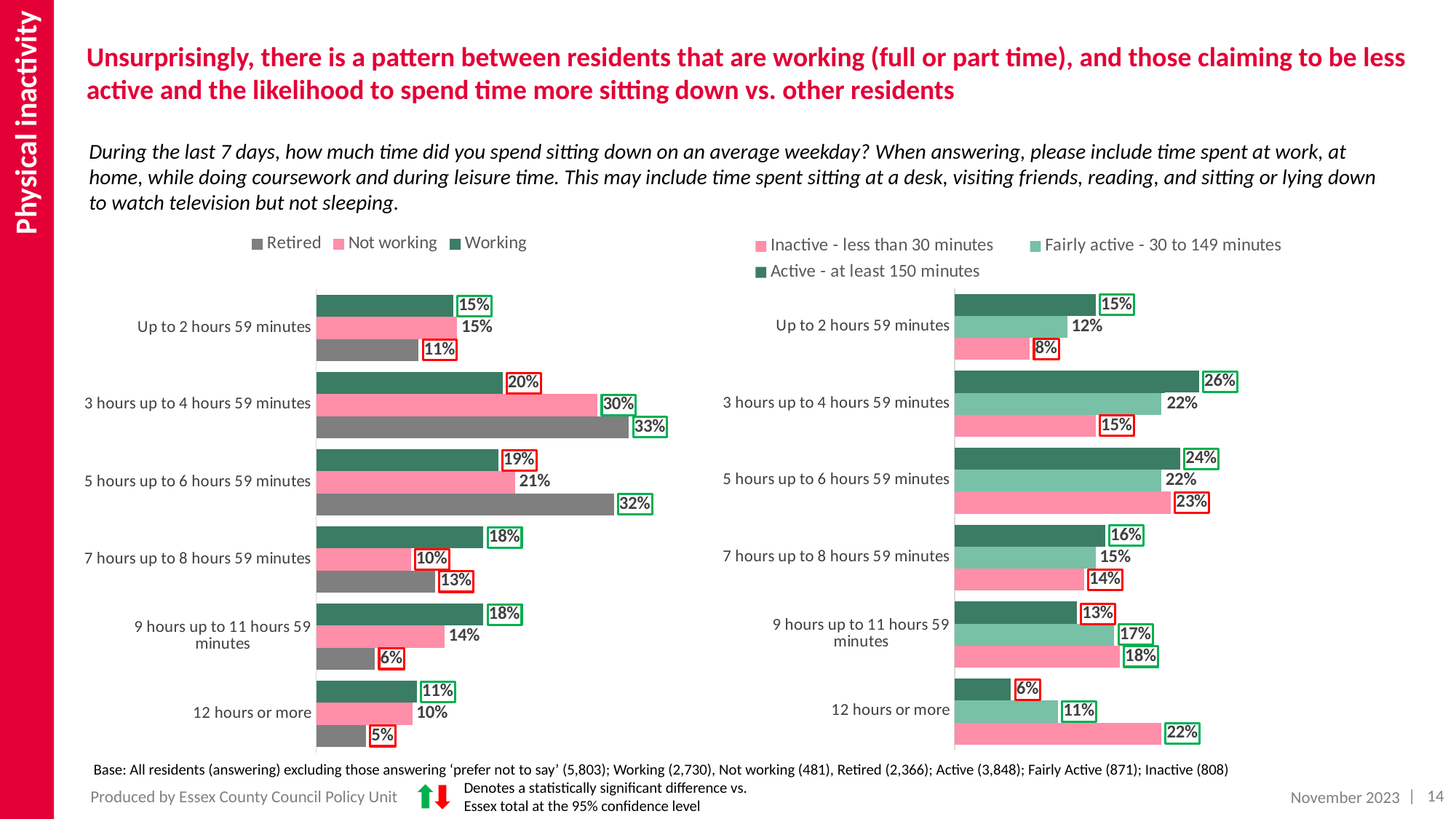
In the left chart, which is larger for 9 hours up to 11 hours 59 minutes: the Working value or the Retired value? Working In the left chart, what is the difference between the Not working and Working values for 3 hours up to 4 hours 59 minutes? 10 percentage points What type of chart is the left chart? Bar chart In the right chart (activity levels), what percentage of inactive residents sit for 12 hours or more? 22% How many series does the legend of the right chart list? 3 In the right chart, what is the difference between the Inactive and Active values for 12 hours or more? 16 percentage points In the left chart, what percentage of working residents sit for 12 hours or more? 11% In the right chart, which sitting-time category has the lowest value for the Active - at least 150 minutes series? 12 hours or more In the left chart (Retired / Not working / Working), what percentage of retired residents sit for 3 hours up to 4 hours 59 minutes? 33% How many sitting-time categories are shown in the left chart? 6 In the left chart, which sitting-time category has the highest value for the Retired series? 3 hours up to 4 hours 59 minutes In the right chart, which is larger for Up to 2 hours 59 minutes: the Active value or the Inactive value? Active